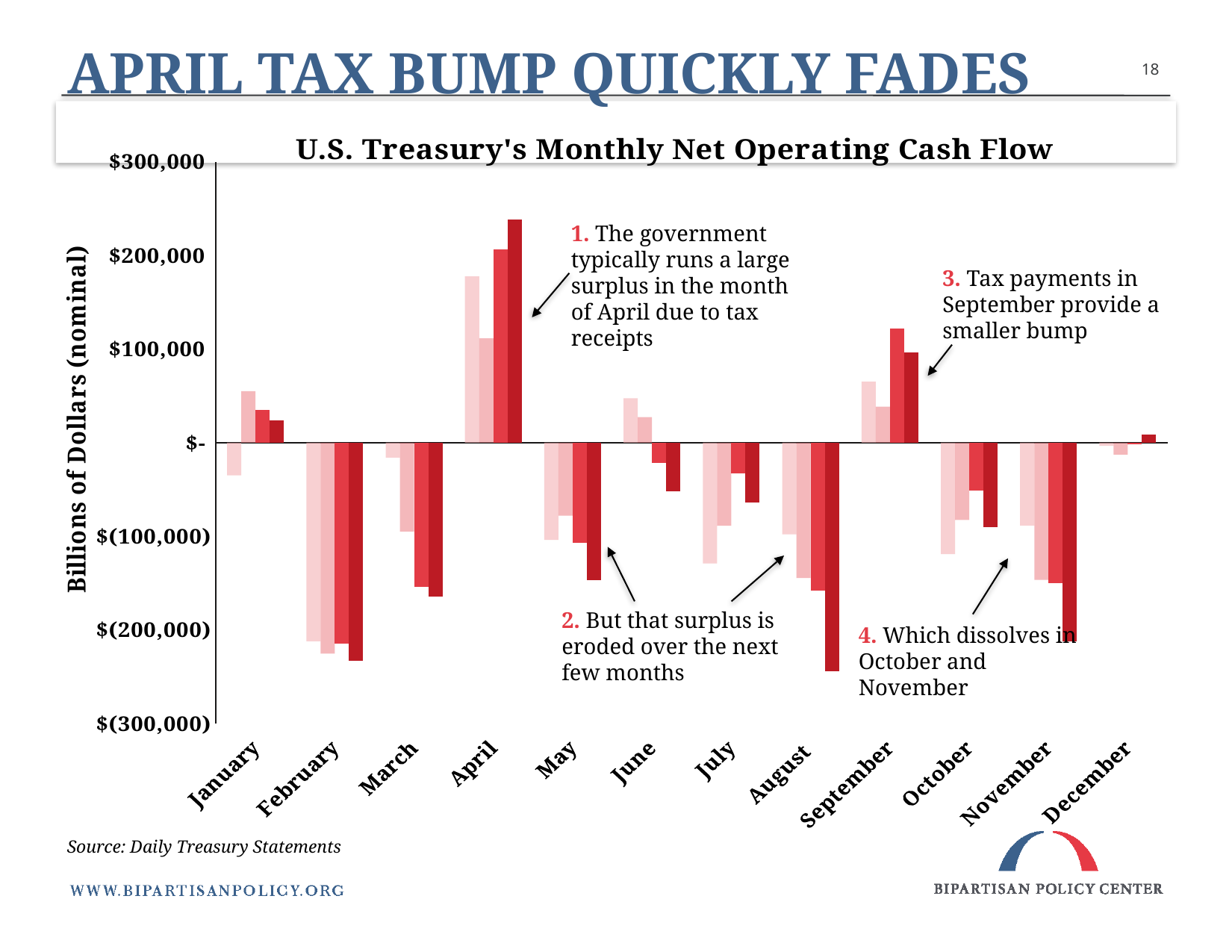
Which month has the larger peak bar, April or September? April What is the label on the y axis of the chart? Billions of Dollars (nominal) Is the tallest April bar greater or less than $200,000? greater Is the tallest January bar greater or less than $100,000? less How many bars are plotted for each month in the chart? 4 Which month has the larger peak bar, September or June? September Which month has the highest bar in the chart? April Is the tallest September bar greater or less than $100,000? greater How many months are shown along the x axis of the chart? 12 What kind of chart is shown on the slide? bar chart What is the title of the chart? U.S. Treasury's Monthly Net Operating Cash Flow Do the bars in the chart rise or fall from April to May? fall